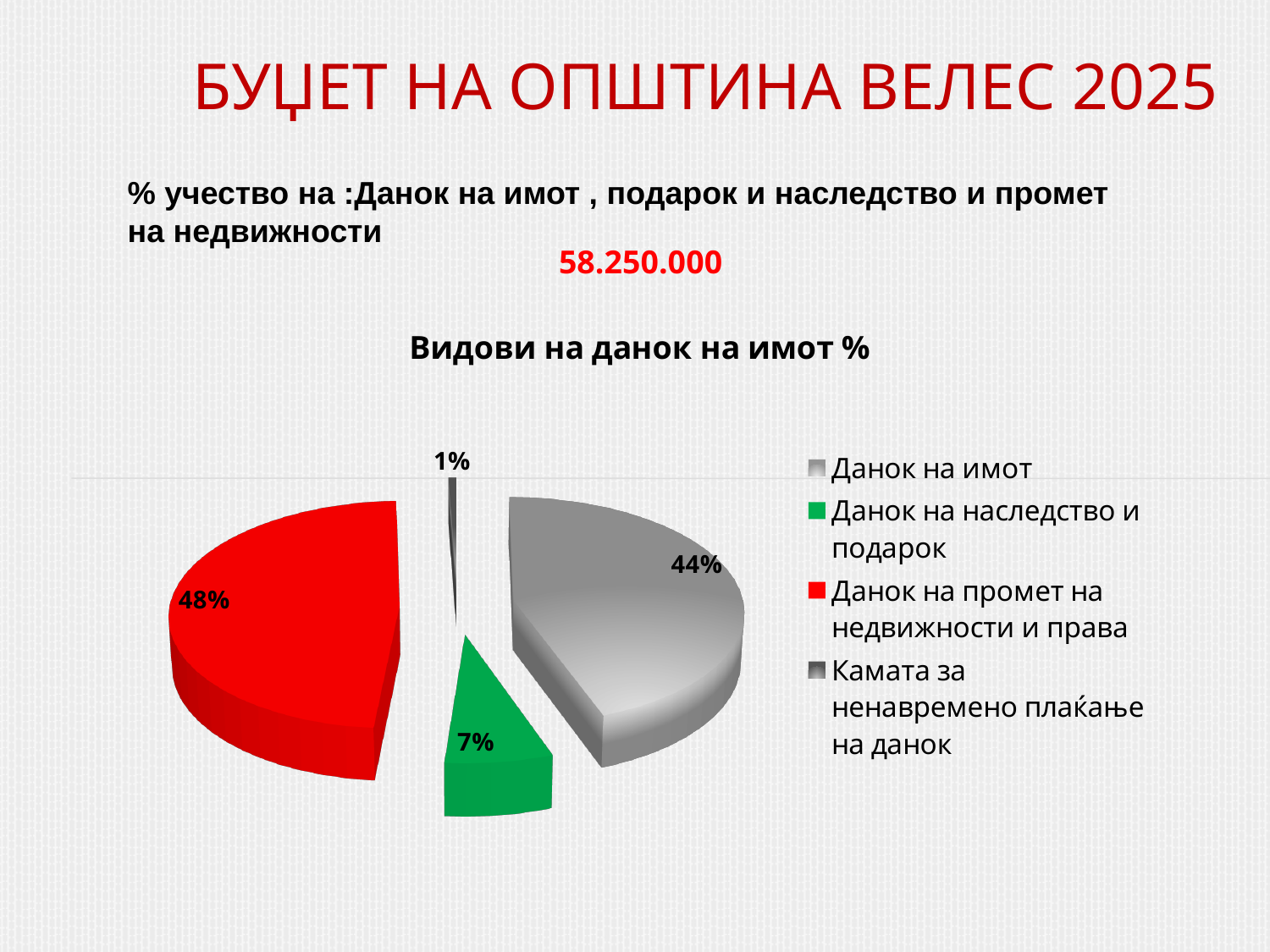
What is the difference between the shares of Данок на промет на недвижности и права and Данок на имот? 4% What kind of chart is shown on the slide? pie chart Which is larger: the share of Данок на имот or the share of Данок на наследство и подарок? Данок на имот What share of the pie does Данок на имот have? 44% How many slices does the pie chart have? 4 What is the title of the chart? Видови на данок на имот % Which category has the largest slice of the pie? Данок на промет на недвижности и права What share of the pie does Данок на промет на недвижности и права have? 48% Which category has the smallest slice of the pie? Камата за ненавремено плаќање на данок What colour is the slice for Данок на наследство и подарок? green What share of the pie does Камата за ненавремено плаќање на данок have? 1% What share of the pie does Данок на наследство и подарок have? 7%